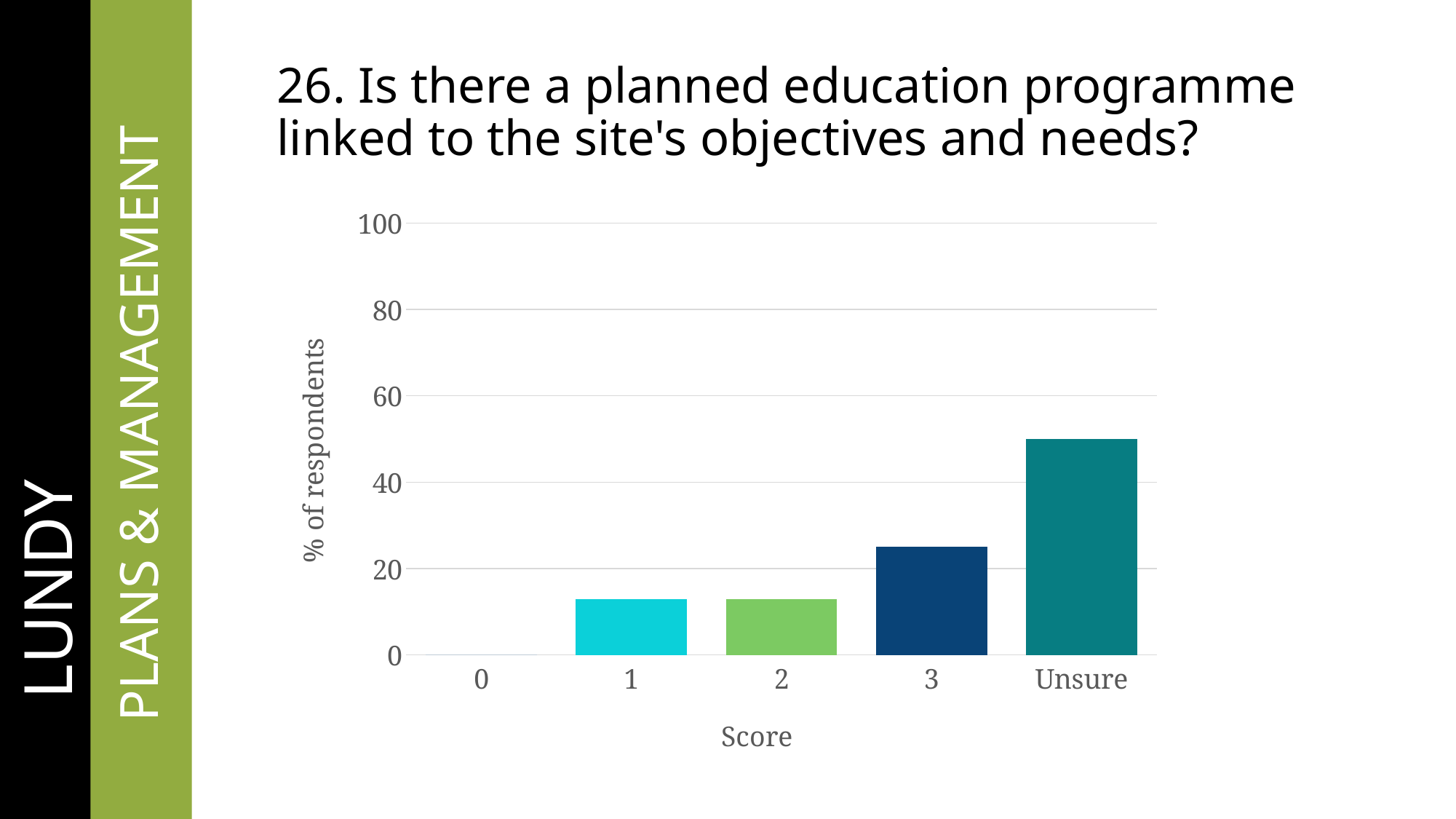
How many score categories are shown on the x axis? 5 Which has a higher percentage of respondents: score 3 or Unsure? Unsure What kind of chart is shown on the slide? bar chart Which score category has the lowest percentage of respondents? 0 What is the label on the y axis of the chart? % of respondents What is the label on the x axis of the chart? Score Is the value for score 3 greater or less than 20? greater Is the value for Unsure greater or less than 40? greater Is the value for score 1 greater or less than 20? less Which score category has the highest percentage of respondents? Unsure Which has a higher percentage of respondents: score 1 or score 3? 3